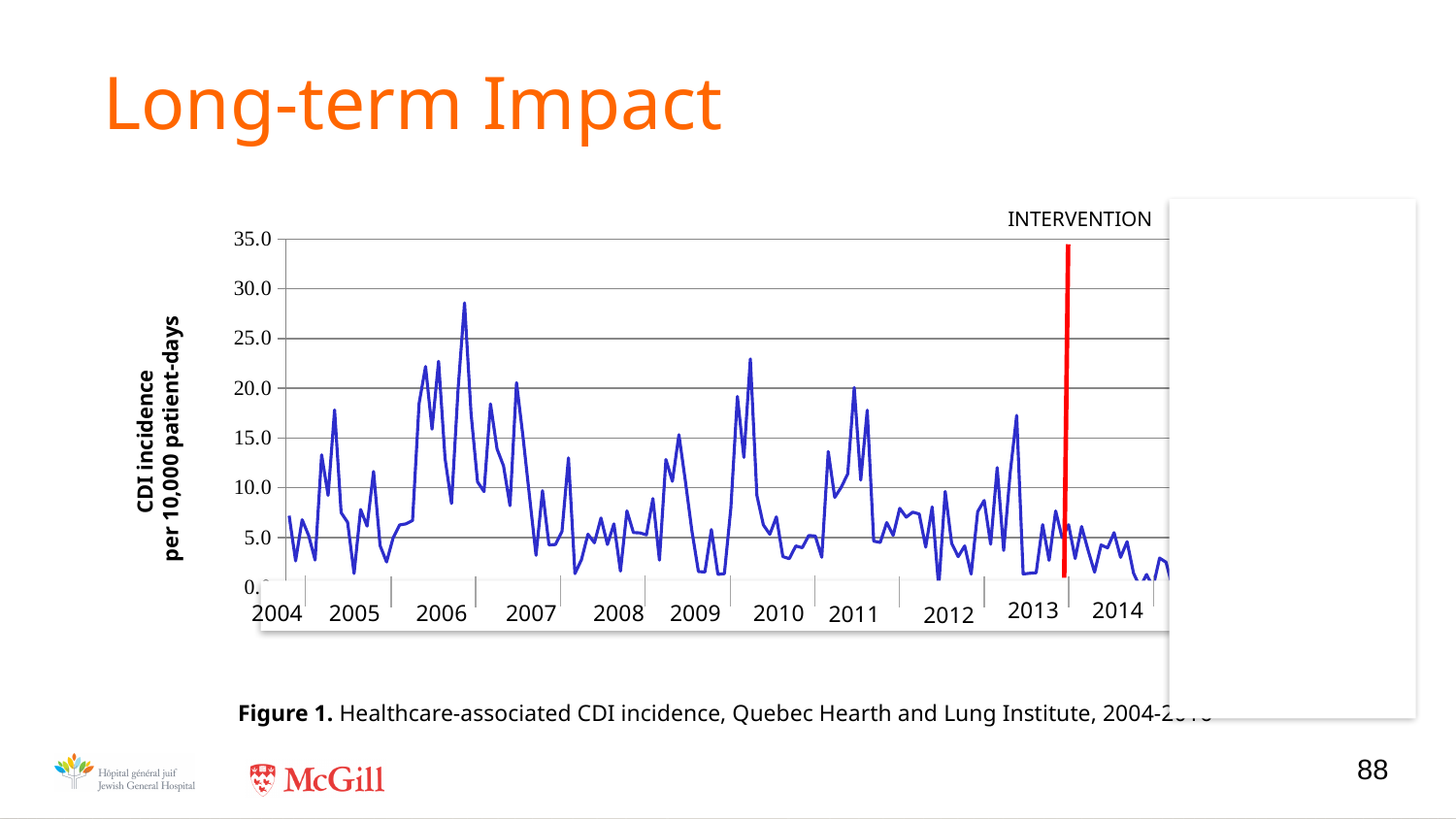
In which year does the line reach its highest peak? 2006 What is the highest value shown on the y axis of the chart? 35.0 Are all the values after the intervention line greater or less than 10.0? less How many year labels are shown along the x axis of the chart? 11 What kind of chart is shown on the slide? line chart Is the peak of the line in 2005 greater or less than 20.0? less What is the label on the y axis of the chart? CDI incidence per 10,000 patient-days What does the red vertical line on the chart mark? INTERVENTION Is the highest peak of the line, in 2006, greater or less than 25.0? greater Do the values generally rise or fall after the intervention line in 2013? fall Which is higher, the peak in 2006 or the peak in 2010? 2006